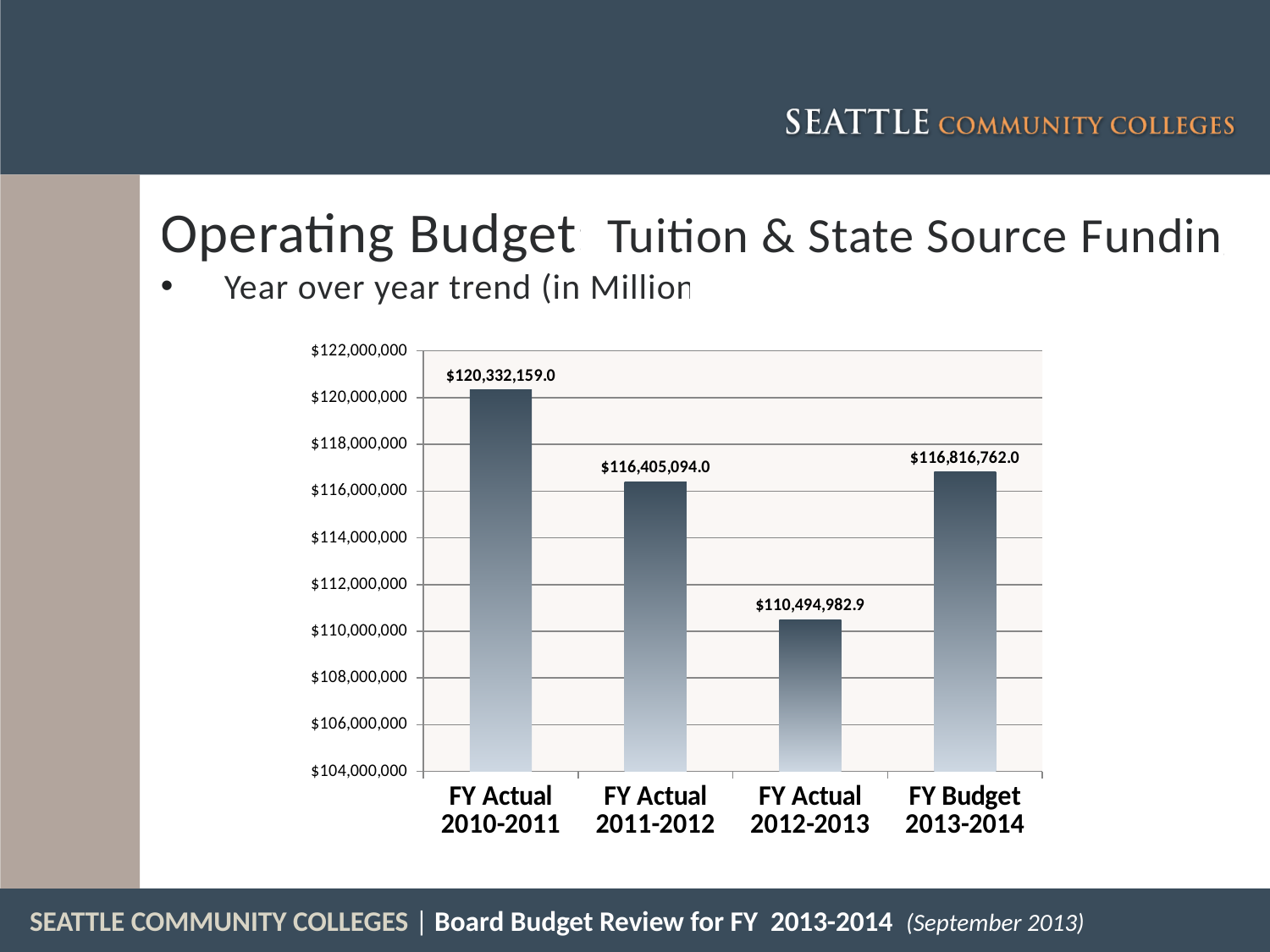
What kind of chart is shown on the slide? bar chart How many fiscal years are shown on the chart? 4 What is the difference between FY Budget 2013-2014 and FY Actual 2012-2013? $6,321,779.1 Which fiscal year has the highest value? FY Actual 2010-2011 Which fiscal year has the lowest value? FY Actual 2012-2013 Is the value for FY Actual 2012-2013 greater or less than $112,000,000? less What is the value for FY Actual 2011-2012? $116,405,094.0 What is the value for FY Actual 2010-2011? $120,332,159.0 What is the value for FY Budget 2013-2014? $116,816,762.0 What is the difference between FY Actual 2010-2011 and FY Actual 2011-2012? $3,927,065.0 What is the value for FY Actual 2012-2013? $110,494,982.9 Which is larger, the value for FY Actual 2011-2012 or FY Budget 2013-2014? FY Budget 2013-2014